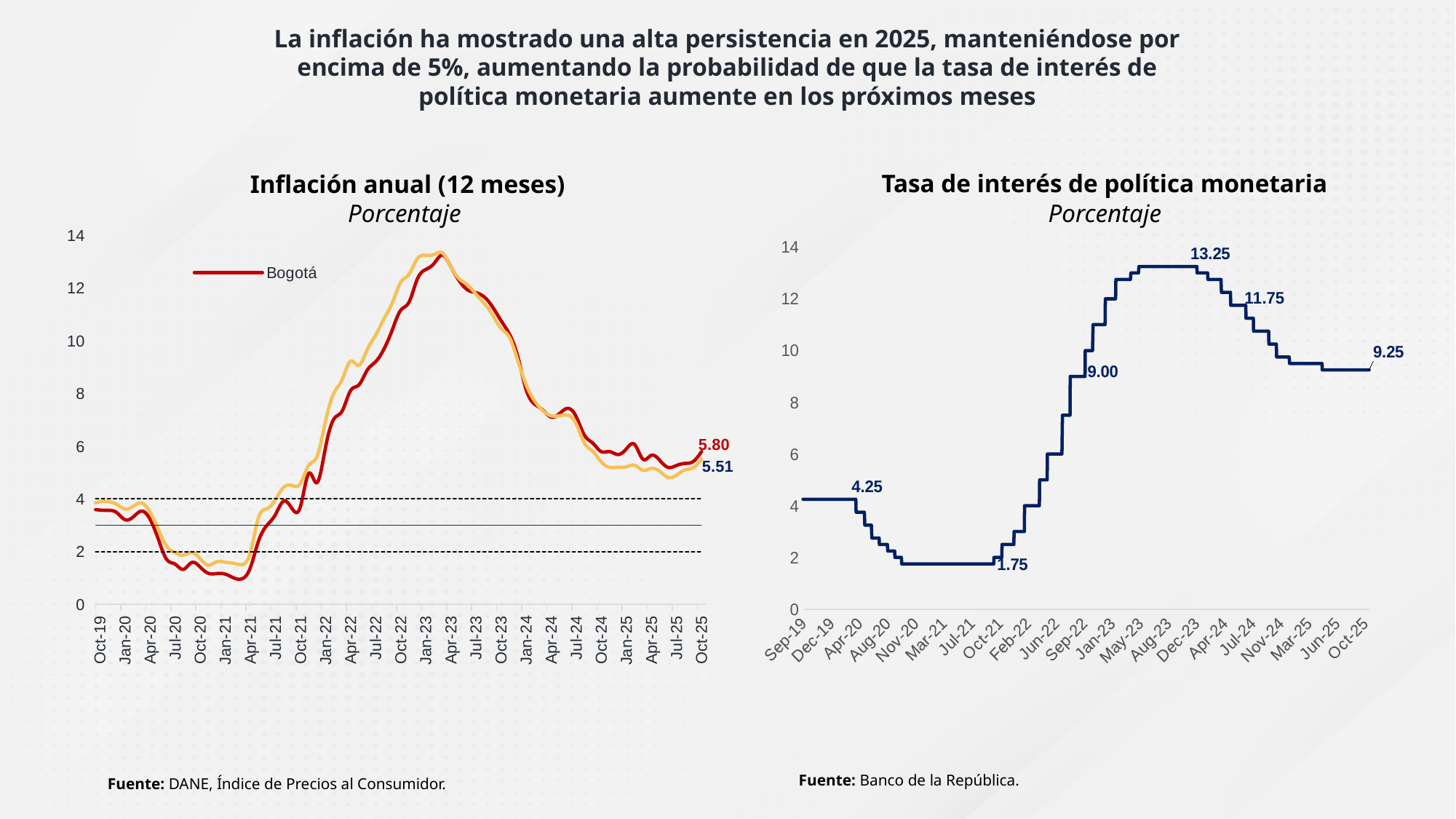
On the 'Inflación anual (12 meses)' chart, what is the value labelled at the end of the yellow line? 5.51 On the 'Inflación anual (12 meses)' chart, what is the value labelled for Bogotá at the end of the series (Oct-25)? 5.80 On the 'Tasa de interés de política monetaria' chart, what is the lowest labelled value? 1.75 On the 'Tasa de interés de política monetaria' chart, is the value at Nov-20 greater or less than 4? less What kind of chart is the 'Tasa de interés de política monetaria' chart? Line chart On the 'Inflación anual (12 meses)' chart, what is the difference between the final labelled values 5.80 and 5.51? 0.29 On the 'Inflación anual (12 meses)' chart, which end-of-series value is larger: the red Bogotá line (5.80) or the yellow line (5.51)? Bogotá (5.80) On the 'Tasa de interés de política monetaria' chart, what is the value labelled at Oct-25? 9.25 On the 'Tasa de interés de política monetaria' chart, what is the difference between the peak value of 13.25 and the final value of 9.25? 4.00 On the 'Tasa de interés de política monetaria' chart, what is the highest labelled value? 13.25 On the 'Inflación anual (12 meses)' chart, which series name appears in the legend? Bogotá On the 'Tasa de interés de política monetaria' chart, what is the difference between the labelled values 13.25 and 11.75? 1.50